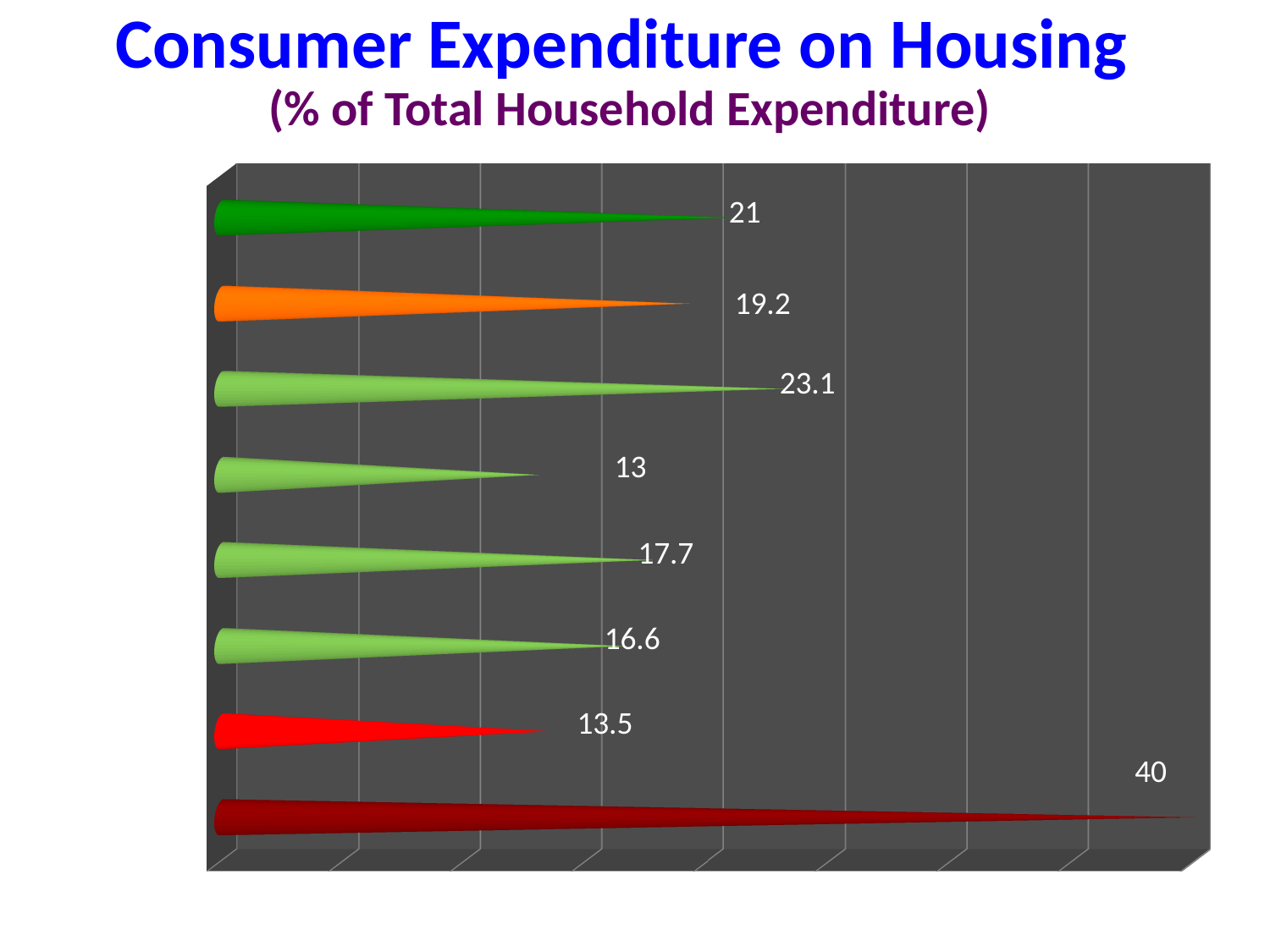
What is the value shown for the top (dark green) bar? 21 Which bar has the highest value? the bottom (dark red) bar, 40 What is the title of the chart on the slide? Consumer Expenditure on Housing What is the value shown for the bottom (dark red) bar? 40 What is the difference between the bottom bar's value (40) and the top bar's value (21)? 19 What kind of chart is shown on the slide? bar chart What unit does the subtitle say the values are expressed in? % of Total Household Expenditure What is the value shown for the orange bar? 19.2 How many bars are plotted in the chart? 8 What is the value shown for the bright red bar (second from the bottom)? 13.5 Which bar has the lowest value? the fourth bar from the top, 13 Which is larger, the value of the orange bar or the value of the third bar from the top? the third bar from the top (23.1)